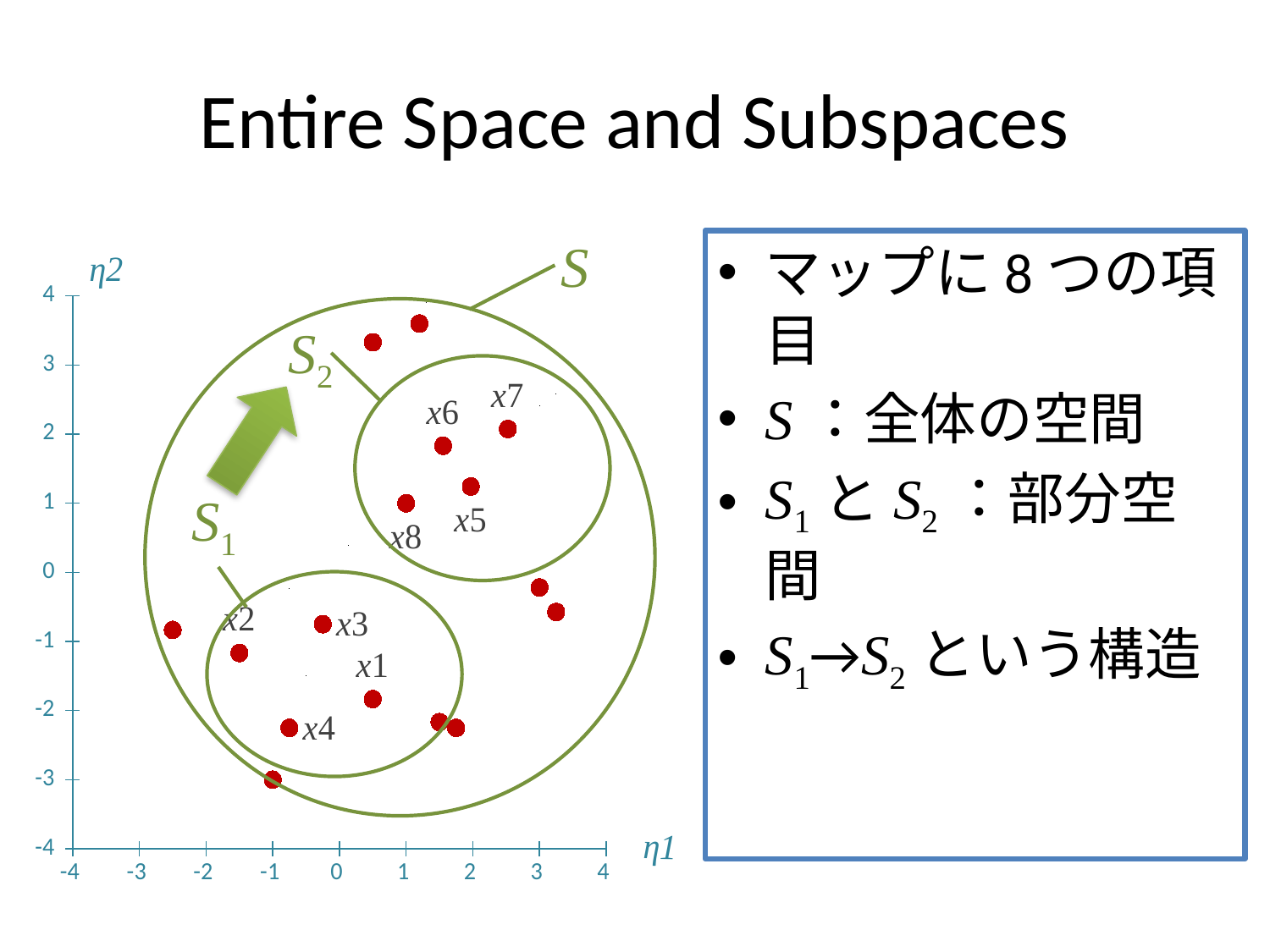
Which point has the larger η2 value, x7 or x4? x7 Is the η1 value of point x2 greater or less than 0? less Among the labeled points x1 to x8, which has the lowest η2 value? x4 Which point has the larger η1 value, x5 or x2? x5 Is the η1 value of point x5 greater or less than 1? greater What is the label of the horizontal axis of the chart? η1 What is the label of the vertical axis of the chart? η2 Is the η2 value of point x1 greater or less than -1? less How many labeled points (x1 to x8) are plotted on the chart? 8 What kind of chart is shown on the slide? scatter plot